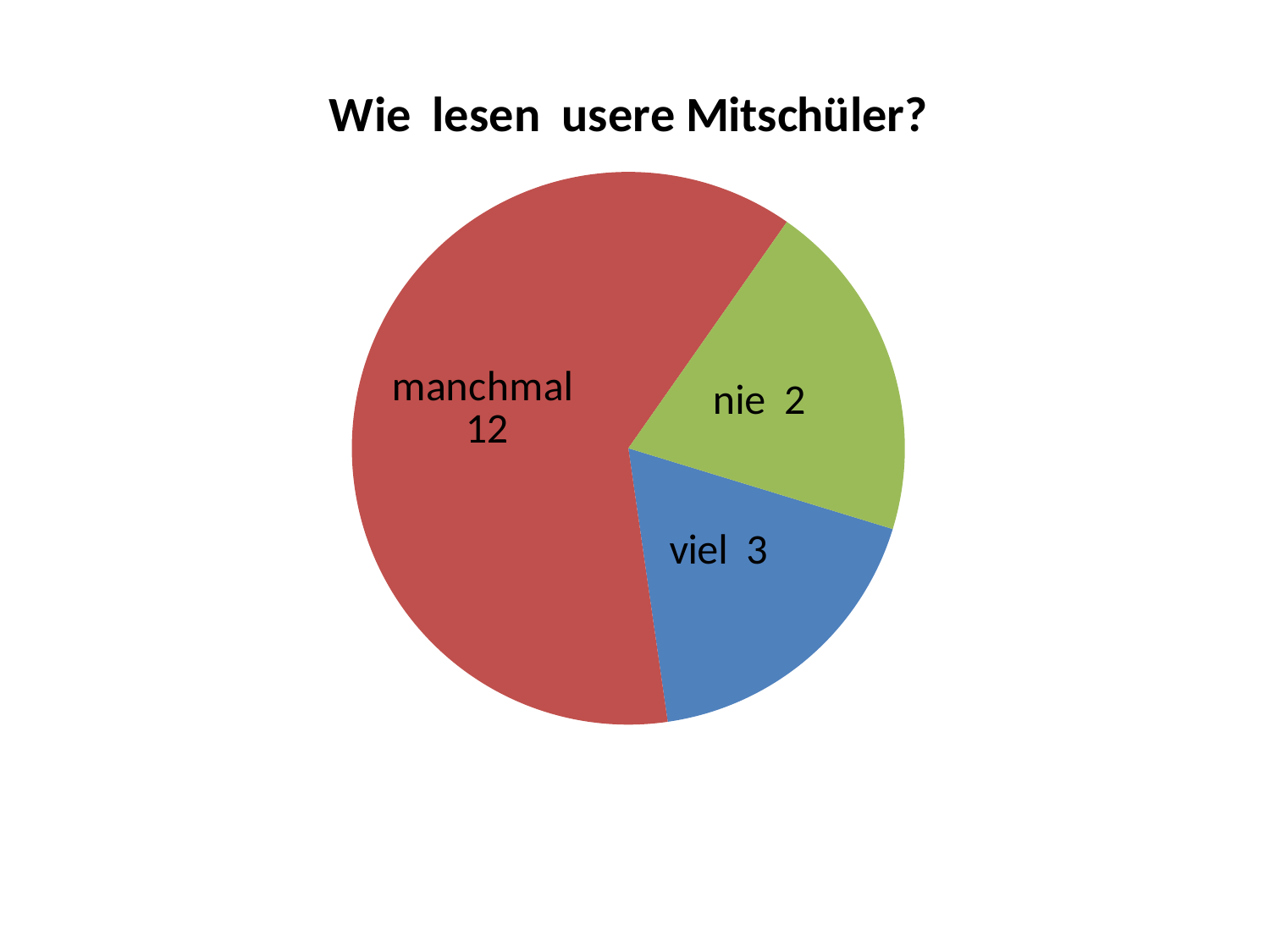
What is the value for "manchmal"? 12 What is the value for "nie"? 2 What share of the pie does "manchmal" represent? 12 of 17 What is the difference between the values for "manchmal" and "viel"? 9 Which category has the highest value? manchmal What kind of chart is shown on the slide? pie chart What is the value for "viel"? 3 How many categories does the pie chart show? 3 Which category has the lowest value? nie Which is larger, the value for "viel" or the value for "nie"? viel What is the title of the chart? Wie lesen usere Mitschüler? What is the total of all slices in the pie chart? 17